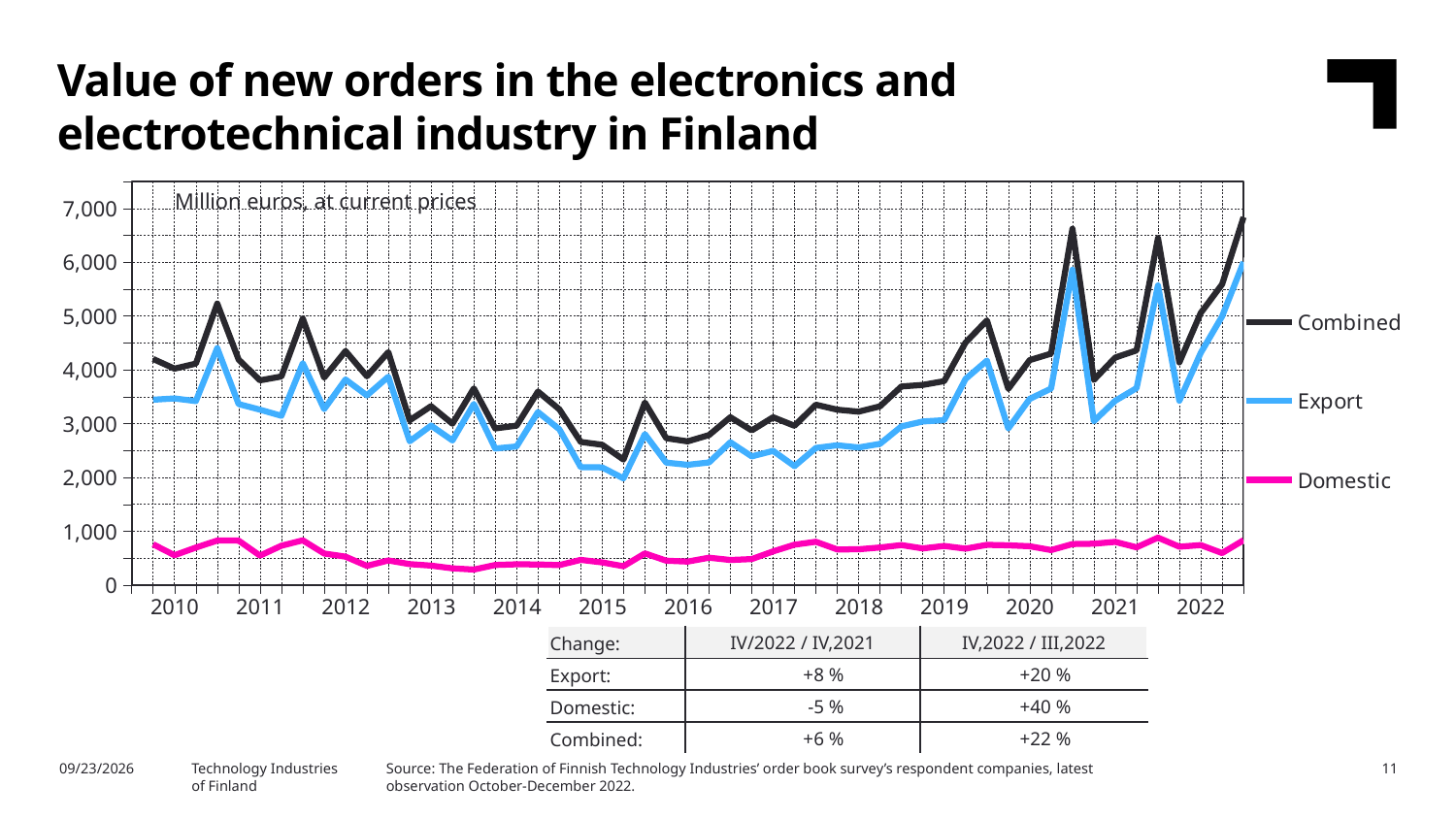
Which series has the lowest values throughout the chart? Domestic Is the highest Combined value in 2022 greater or less than 6,000? greater Is the Export value in 2015 greater or less than 3,000? less How many series does the legend list? 3 What kind of chart is shown on the slide? line chart What unit is stated for the values on the chart? Million euros, at current prices Which is larger in 2018, the Export value or the Domestic value? Export Which series has the highest values throughout the chart? Combined Does the Combined series generally rise or fall from 2019 to 2022? rise How many years are labelled on the x axis? 13 Is the Domestic value in 2015 greater or less than 1,000? less What are the three series named in the legend? Combined, Export, Domestic